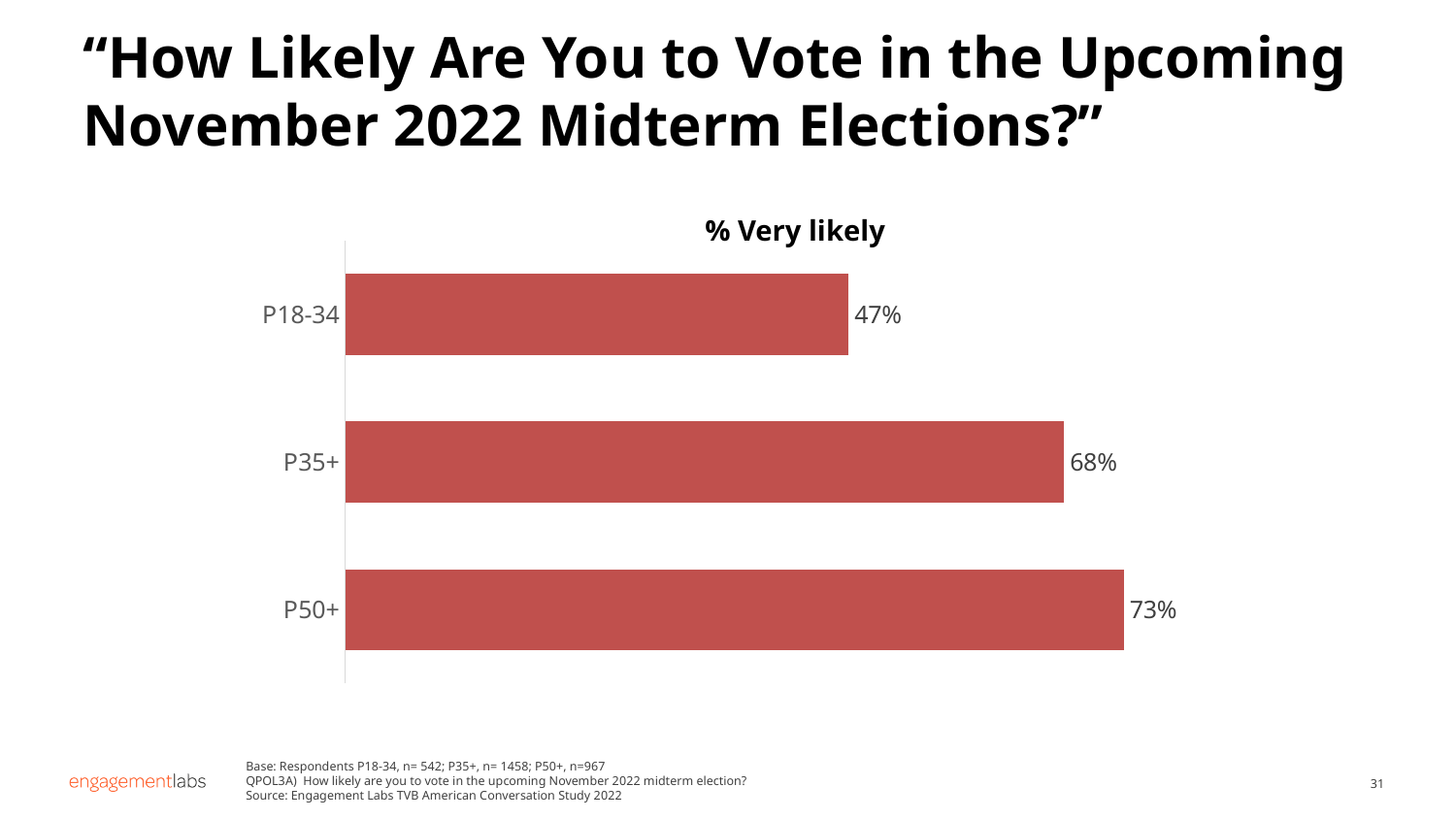
Which category has the lowest value? P18-34 What kind of chart is shown on the slide? Bar chart Which is larger, the value for P35+ or the value for P18-34? P35+ How many categories are shown in the chart? 3 What is the difference between the values for P50+ and P18-34? 26% What is the value for P50+? 73% What is the value for P18-34? 47% Which category has the highest value? P50+ What is the title of the chart? % Very likely What is the difference between the values for P50+ and P35+? 5% What colour are the bars in the chart? Red What is the value for P35+? 68%